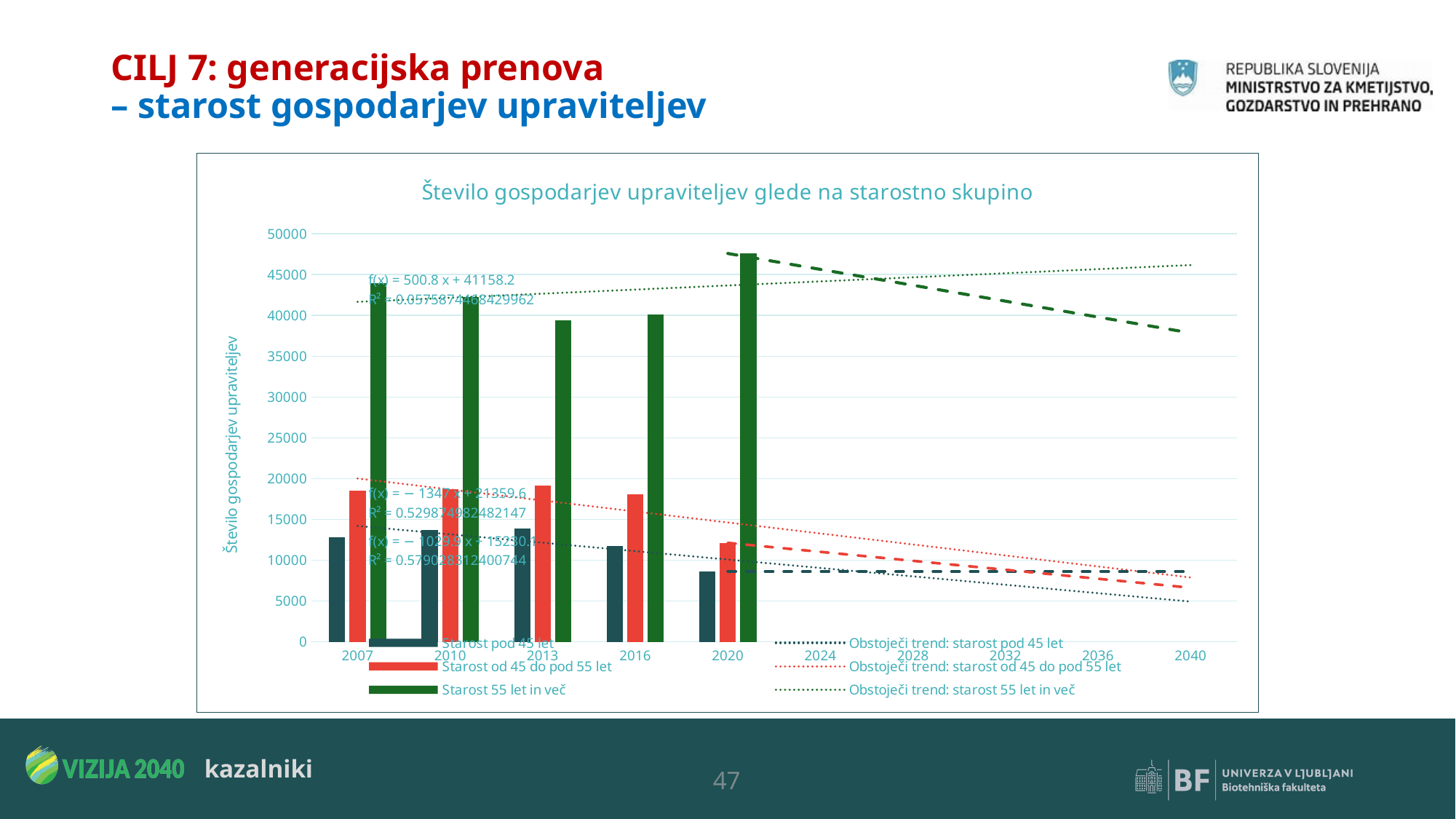
In which year is the bar for 'Starost pod 45 let' the lowest? 2020 Does the value for 'Starost pod 45 let' rise or fall from 2016 to 2020? fall How many entries does the legend of the chart list? 6 What is the title of the chart? Število gospodarjev upraviteljev glede na starostno skupino In which year is the bar for 'Starost 55 let in več' the highest? 2020 Is the value for 'Starost od 45 do pod 55 let' in 2013 greater or less than 20000? less Which is larger: the bar for 'Starost 55 let in več' in 2007 or in 2016? 2007 What kind of chart is shown on the slide? bar chart Is the value for 'Starost 55 let in več' in 2020 greater or less than 45000? greater In 2007, which is larger: the bar for 'Starost pod 45 let' or the bar for 'Starost od 45 do pod 55 let'? Starost od 45 do pod 55 let Is the value for 'Starost pod 45 let' in 2020 greater or less than 10000? less How many years have bars plotted in the chart? 5